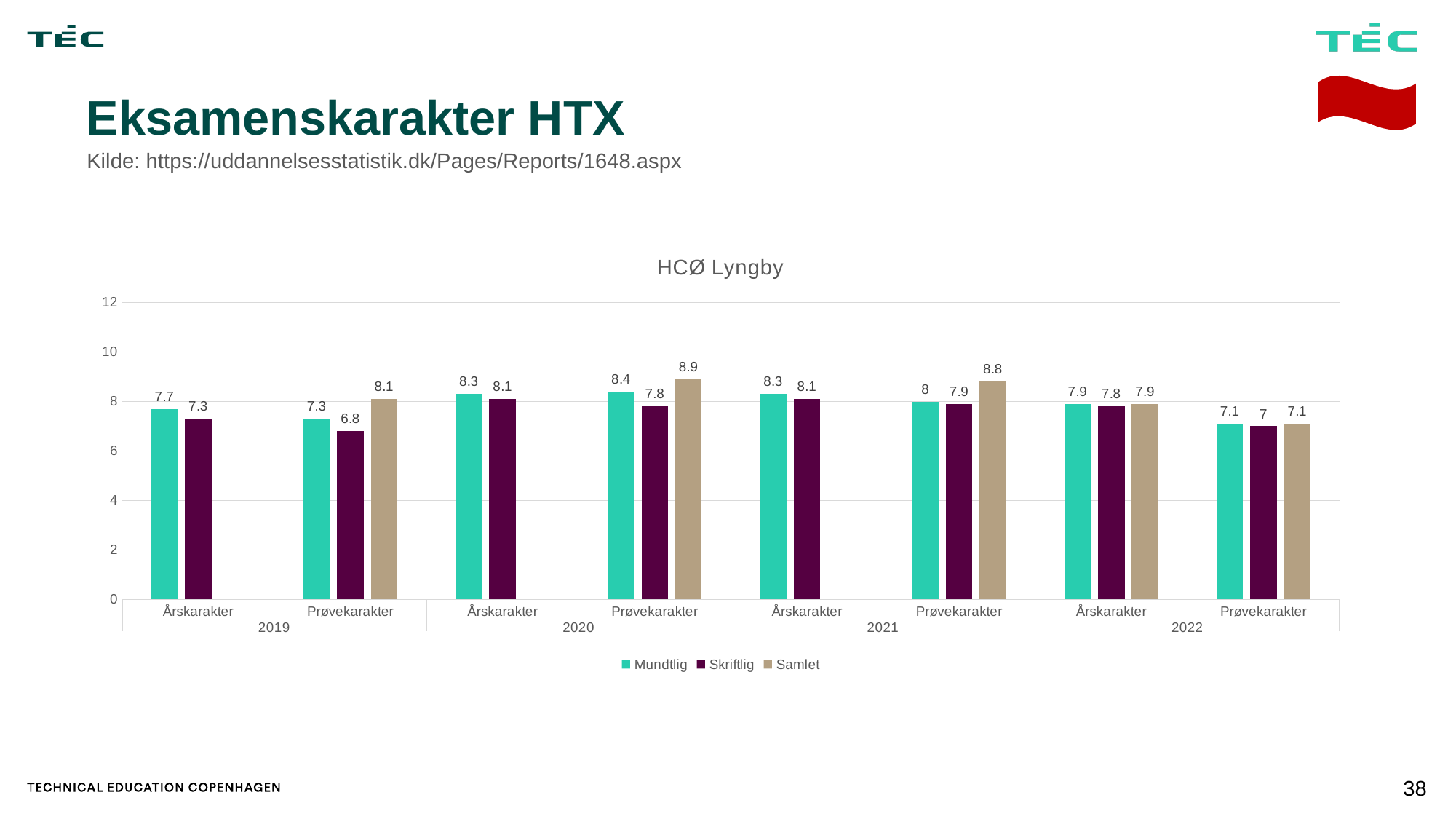
What is the Skriftlig value for Prøvekarakter in 2019? 6.8 What is the Samlet value for Prøvekarakter in 2020? 8.9 What is the Mundtlig value for Årskarakter in 2019? 7.7 Which series has the lowest value for Prøvekarakter in 2022? Skriftlig Which is larger, the Mundtlig value for Årskarakter in 2020 or the Mundtlig value for Årskarakter in 2022? Årskarakter in 2020 How many series does the legend list? 3 What kind of chart is shown on the slide? bar chart What is the difference between the Samlet and Skriftlig values for Prøvekarakter in 2020? 1.1 What is the Mundtlig value for Prøvekarakter in 2021? 8 Is the Samlet value for Prøvekarakter in 2022 greater or less than 8? less Which series has the highest value for Prøvekarakter in 2021? Samlet What is the title of the chart? HCØ Lyngby